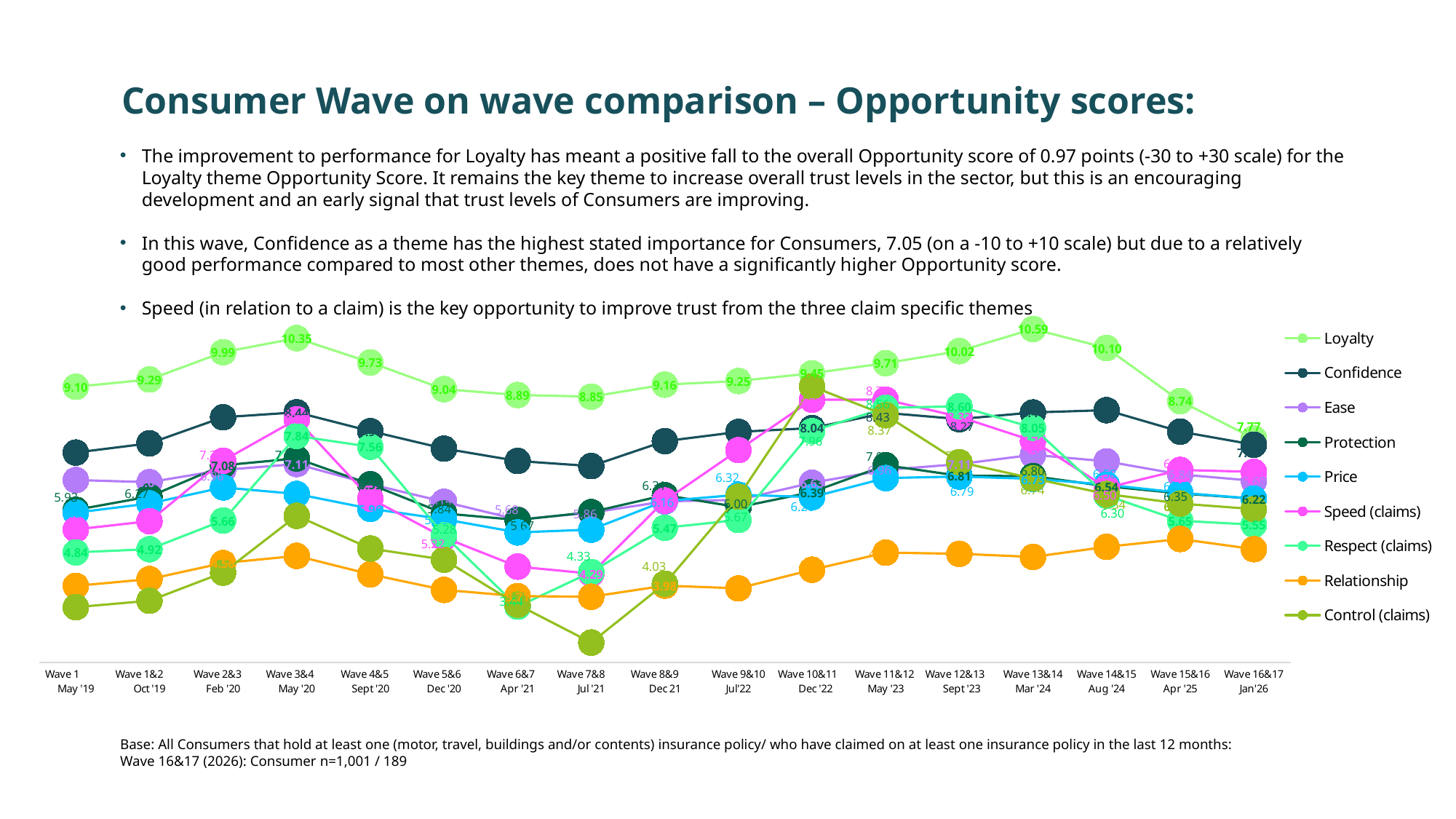
What is the Loyalty Opportunity score for Wave 13&14 (Mar '24)? 10.59 At which wave does the Loyalty series reach its highest value? Wave 13&14 (Mar '24) What is the difference between the Loyalty score at Wave 13&14 and at Wave 16&17? 2.82 What is the Loyalty Opportunity score for Wave 16&17 (Jan '26)? 7.77 What kind of chart is shown on the slide? line chart How many series does the legend list? 9 How many waves are plotted along the x axis? 17 Does the Loyalty series rise or fall from Wave 13&14 to Wave 16&17? fall What is the Loyalty Opportunity score for Wave 1 (May '19)? 9.10 Which series has the highest value at Wave 1 (May '19)? Loyalty Which series has the lowest value at Wave 7&8 (Jul '21)? Control (claims) At which wave does the Loyalty series reach its lowest value? Wave 16&17 (Jan '26)